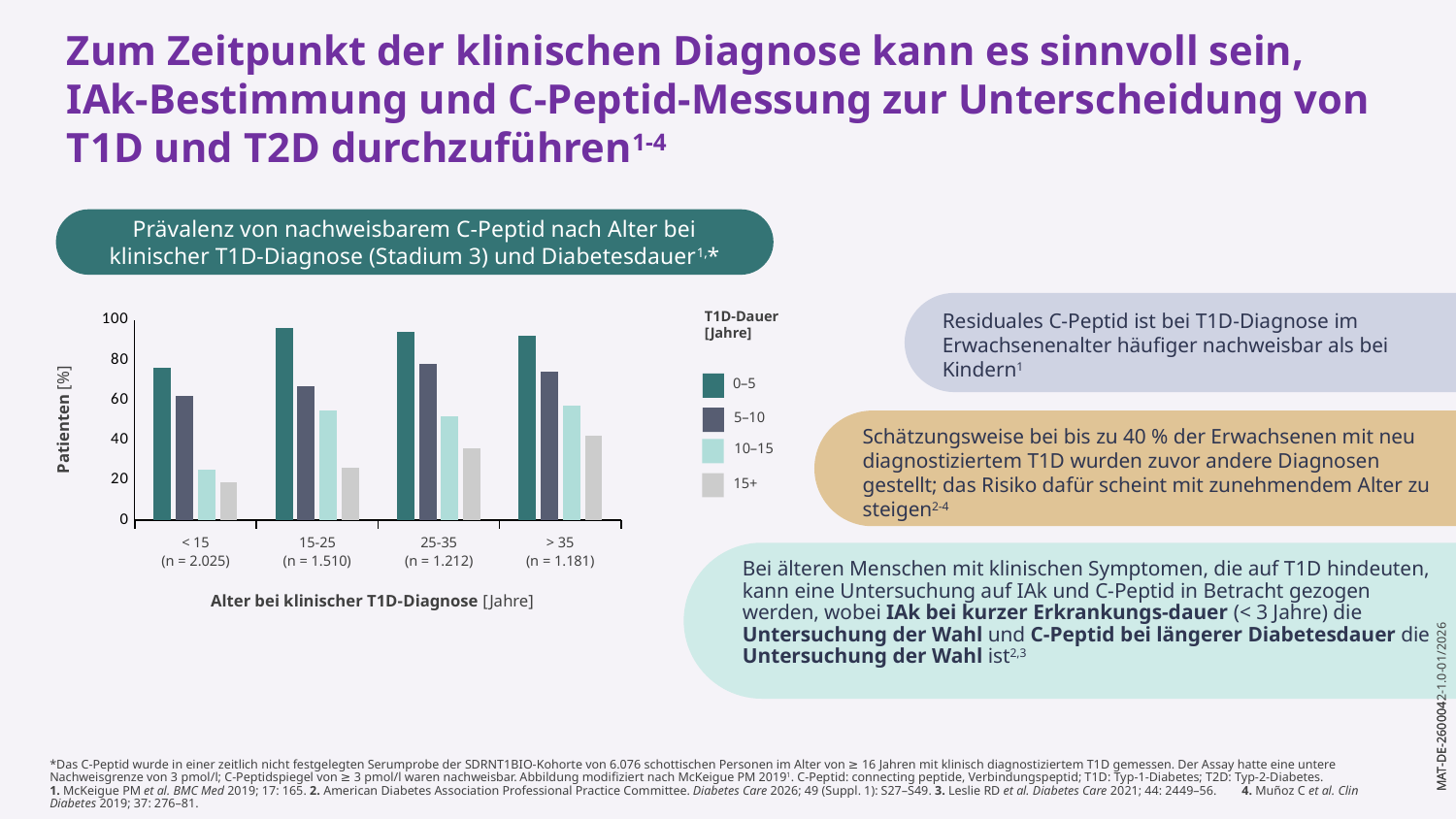
Which is larger: the 5–10 years value for the 25-35 age group or the 5–10 years value for the 15-25 age group? 25-35 What kind of chart is shown on the slide? bar chart Is the value for the 0–5 years series in the 15-25 age group greater or less than 80? greater How many series does the legend 'T1D-Dauer [Jahre]' list? 4 What is the sample size (n) shown for the 15-25 age group? n = 1.510 Which age group has the lowest value for the 0–5 years series? < 15 What is the label of the y axis of the chart? Patienten [%] Which age group has the highest value for the 15+ years series? > 35 Is the value for the 10–15 years series in the < 15 age group greater or less than 40? less Is the value for the 0–5 years series in the < 15 age group greater or less than 60? greater How many age categories are shown on the x axis of the chart? 4 Do the values for the 15+ years series rise or fall as age at diagnosis increases along the x axis? rise